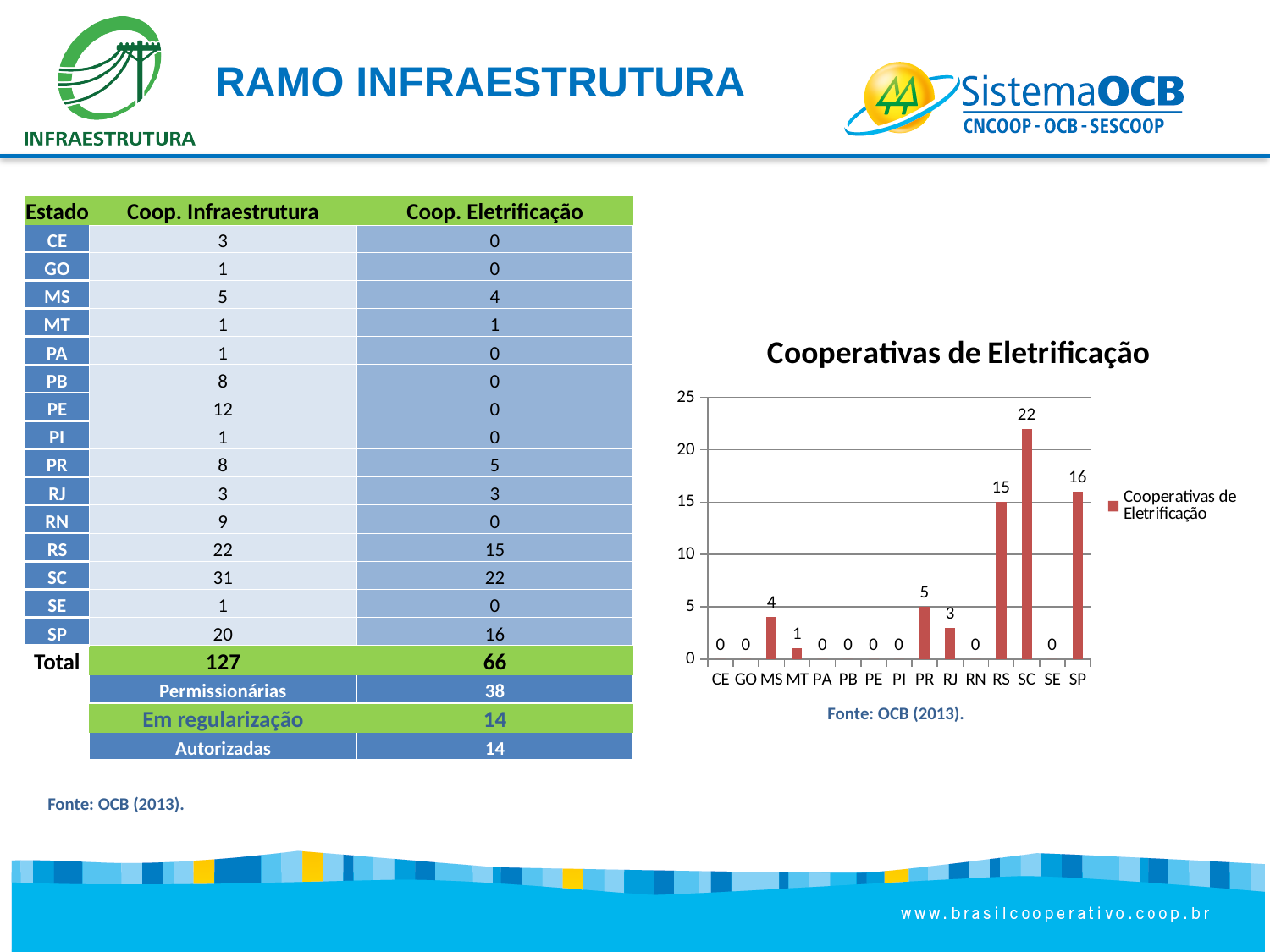
What is the value for PR in the Cooperativas de Eletrificação chart? 5 What is the value for MT in the Cooperativas de Eletrificação chart? 1 Which is larger in the Cooperativas de Eletrificação chart, the value for MS or the value for RJ? MS Which state has the highest value in the Cooperativas de Eletrificação chart? SC What is the difference between the values for SC and SP in the Cooperativas de Eletrificação chart? 6 What is the value for RS in the Cooperativas de Eletrificação chart? 15 What is the title of the chart on the slide? Cooperativas de Eletrificação What is the value for SC in the Cooperativas de Eletrificação chart? 22 How many states are shown on the x axis of the Cooperativas de Eletrificação chart? 15 What kind of chart is the Cooperativas de Eletrificação chart? bar chart Is the value for SC in the Cooperativas de Eletrificação chart greater or less than 20? greater How many series does the legend of the Cooperativas de Eletrificação chart list? 1